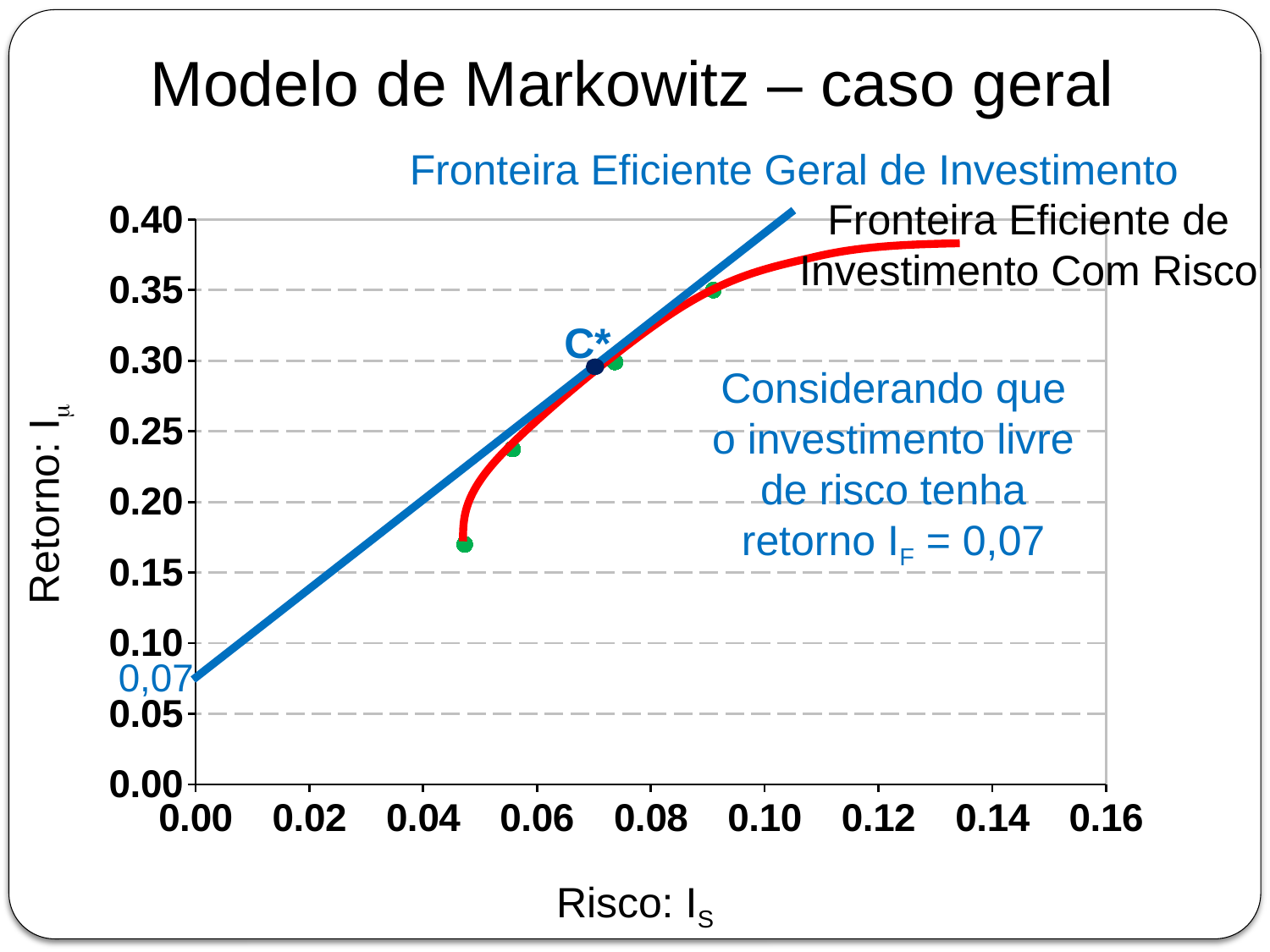
How many green points are marked on the red curve? 4 What is the label of the x axis? Risco: I_S Which has the higher return, the leftmost green point or the rightmost green point on the red curve? the rightmost green point What kind of chart is shown on the slide? line chart Is the return at point C* greater or less than 0.25? greater Which line does the legend text 'Fronteira Eficiente Geral de Investimento' refer to, the straight blue line or the curved red line? the straight blue line What is the highest value shown on the y axis? 0.40 Is the risk at point C* greater or less than 0.08? less At what return value does the blue line meet the y axis (risk 0.00)? 0,07 Is the return of the highest green point on the red curve greater or less than 0.30? greater Does the red curve rise or fall as risk increases along the x axis? rise